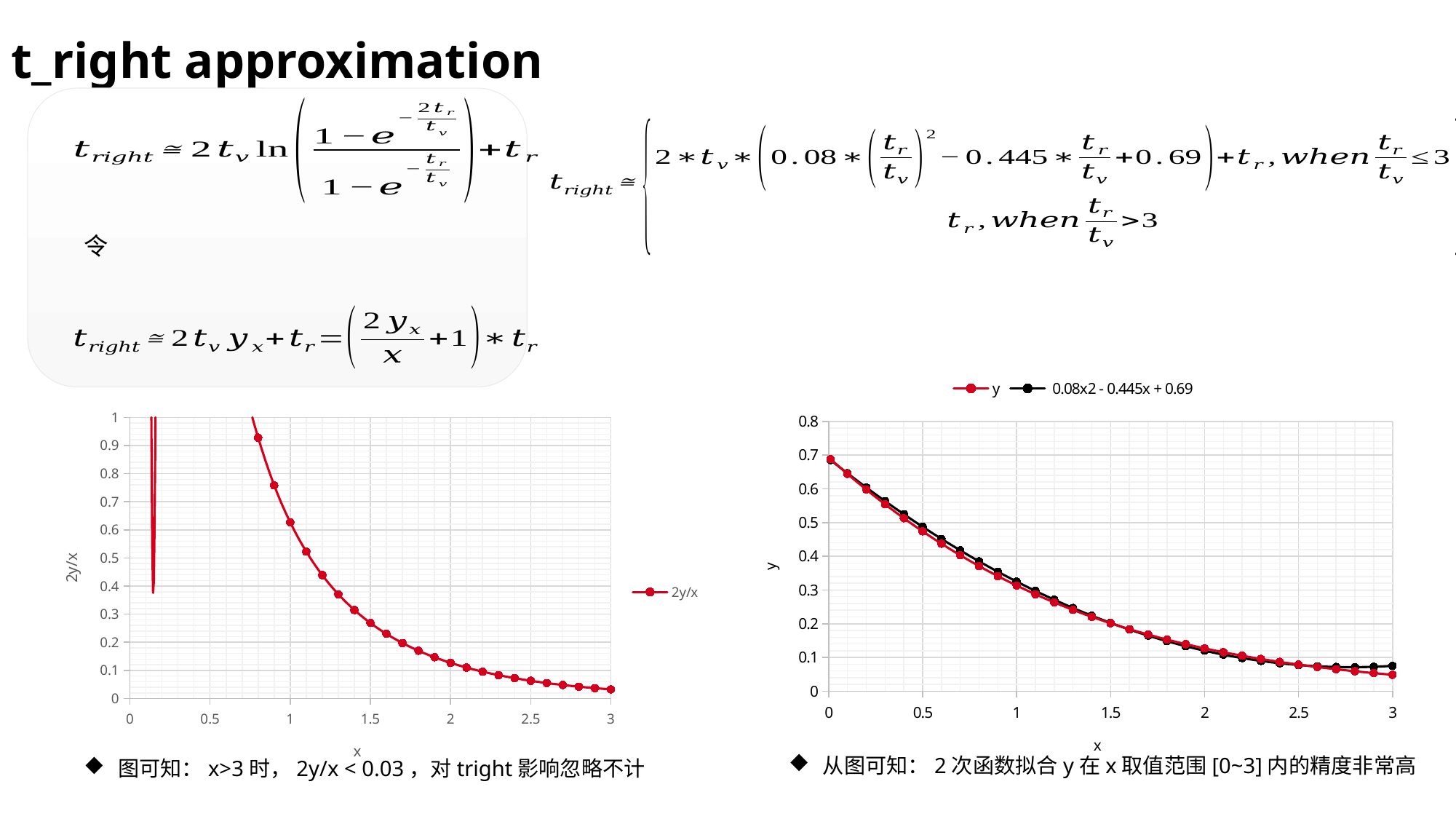
In the left chart, is the value of 2y/x at x = 1 greater or less than 0.5? greater In the right chart, is the value of y at x = 0 greater or less than 0.6? greater In the right chart, is the value of y at x = 3 greater or less than 0.1? less In the right chart, do the values of y rise or fall as x increases from 0 to 3? fall What kind of chart is the left chart (2y/x vs x)? line chart In the right chart, what are the two legend entries? y and 0.08x2 - 0.445x + 0.69 What is the label on the vertical axis of the left chart? 2y/x What kind of chart is the right chart (y vs x)? line chart In the left chart, do the values of 2y/x rise or fall as x increases from 1 to 3? fall How many series does the legend of the right chart list? 2 How many series does the legend of the left chart list? 1